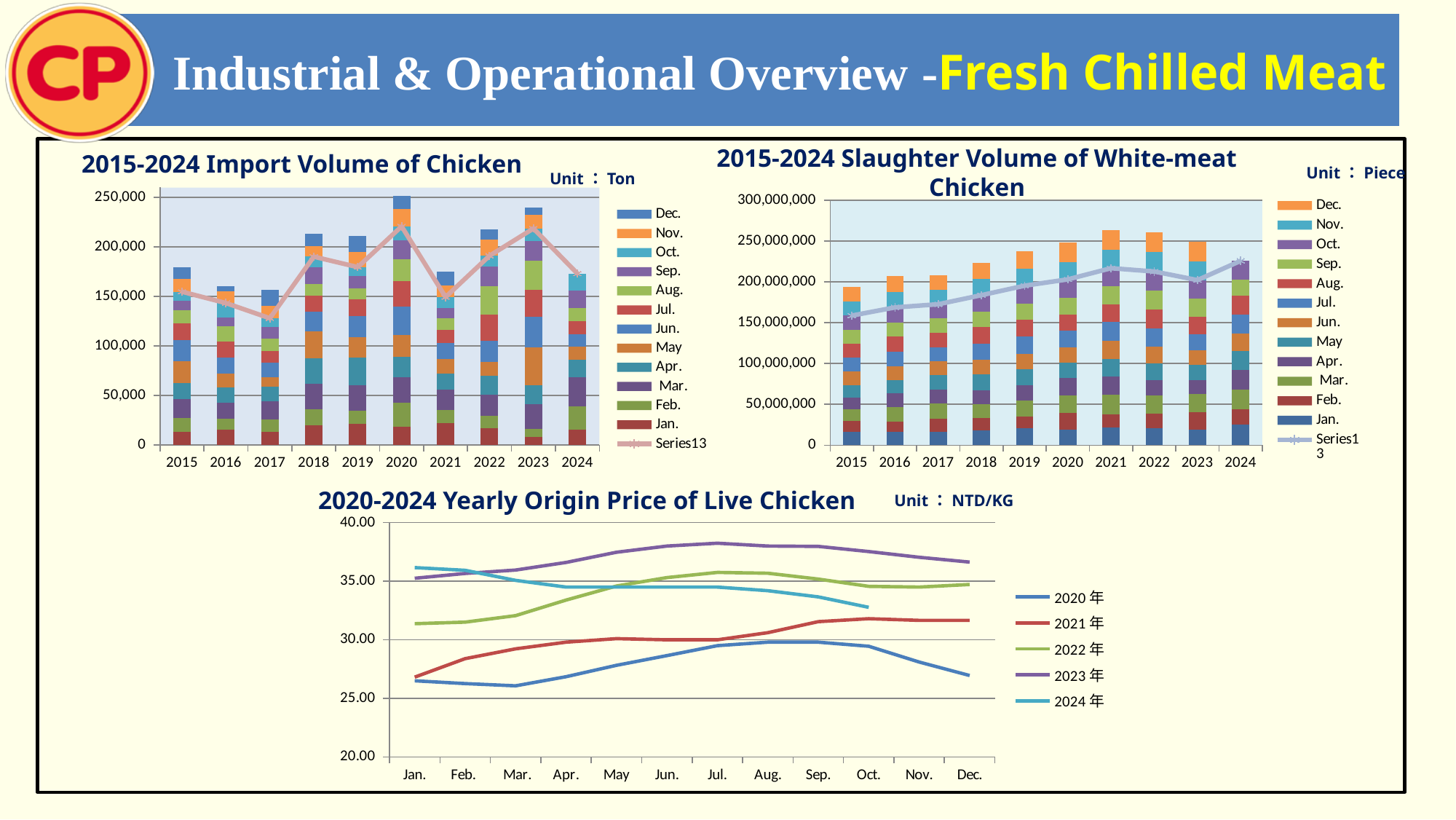
How many years are shown on the x axis of the '2015-2024 Import Volume of Chicken' chart? 10 In the '2015-2024 Slaughter Volume of White-meat Chicken' chart, is the total bar for 2015 greater or less than 200,000,000? less How many series does the legend of the '2020-2024 Yearly Origin Price of Live Chicken' chart list? 5 In the '2015-2024 Import Volume of Chicken' chart, is the total bar for 2021 greater or less than 200,000? less In the '2015-2024 Slaughter Volume of White-meat Chicken' chart, is the total bar for 2021 greater or less than 250,000,000? greater In the '2015-2024 Import Volume of Chicken' chart, which year has the tallest bar? 2020 What type of chart is the '2020-2024 Yearly Origin Price of Live Chicken' chart? Line chart What type of chart is the '2015-2024 Import Volume of Chicken' chart? Combination stacked bar and line chart What unit is stated for the '2015-2024 Import Volume of Chicken' chart? Ton In the '2015-2024 Slaughter Volume of White-meat Chicken' chart, which year has the shortest bar? 2015 In the '2020-2024 Yearly Origin Price of Live Chicken' chart, which is higher in Jul., the 2023 line or the 2020 line? 2023